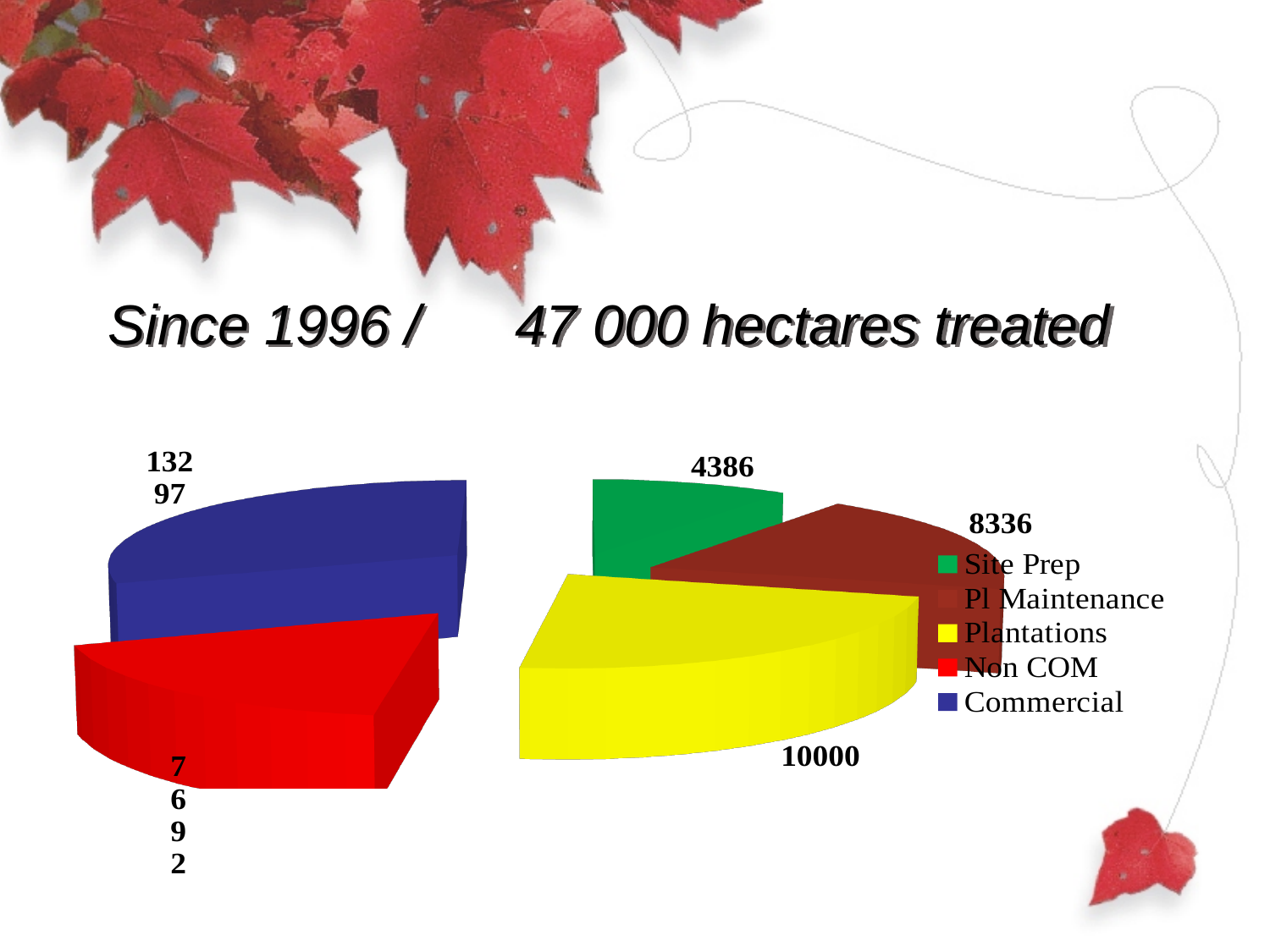
Which is larger, the value for Non COM or the value for Site Prep? Non COM What is the value for Plantations? 10000 Which category has the smallest slice of the pie? Site Prep What is the difference between the values for Pl Maintenance and Site Prep? 3950 What is the value for Pl Maintenance? 8336 Which category has the largest slice of the pie? Commercial What colour is the Plantations slice? yellow How many slices does the pie chart have? 5 What is the value for Site Prep? 4386 What is the value for Non COM? 7692 What kind of chart is shown on the slide? pie chart What is the difference between the values for Plantations and Pl Maintenance? 1664